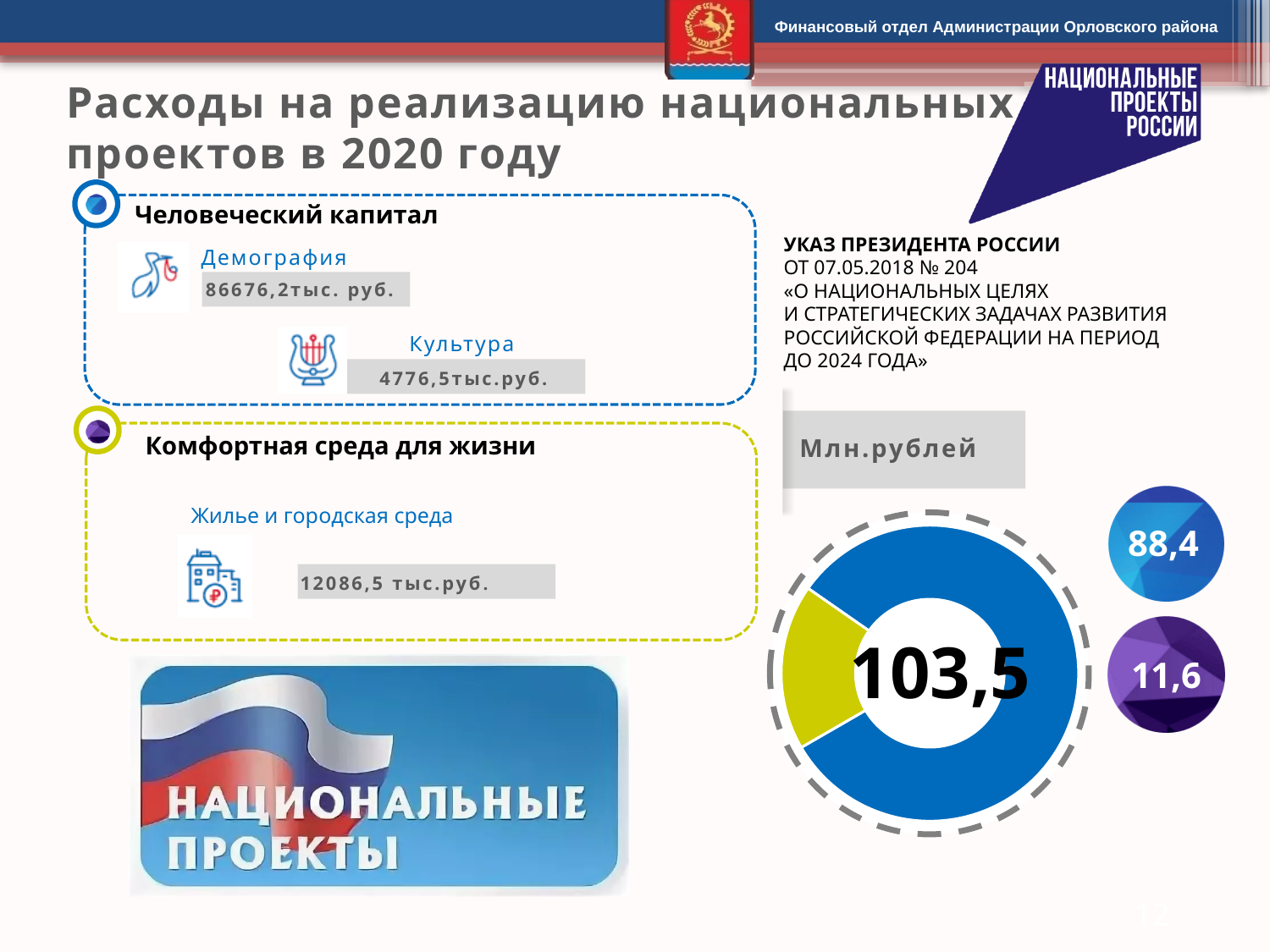
What value is printed in the centre of the donut chart? 103,5 Which of the two values beside the donut chart is the smallest? 11,6 What unit is shown in the grey box above the donut chart? Млн.рублей What value is shown in the purple circle next to the donut chart? 11,6 How many slices does the donut chart have? 2 What kind of chart is shown on the right side of the slide? pie chart (donut) What colour is the smallest slice of the donut chart? yellow What is the difference between the two values shown beside the donut chart, 88,4 and 11,6? 76,8 Which slice of the donut chart is larger, the blue one or the yellow one? the blue one Which of the two values beside the donut chart is the largest? 88,4 What value is shown in the blue circle next to the donut chart? 88,4